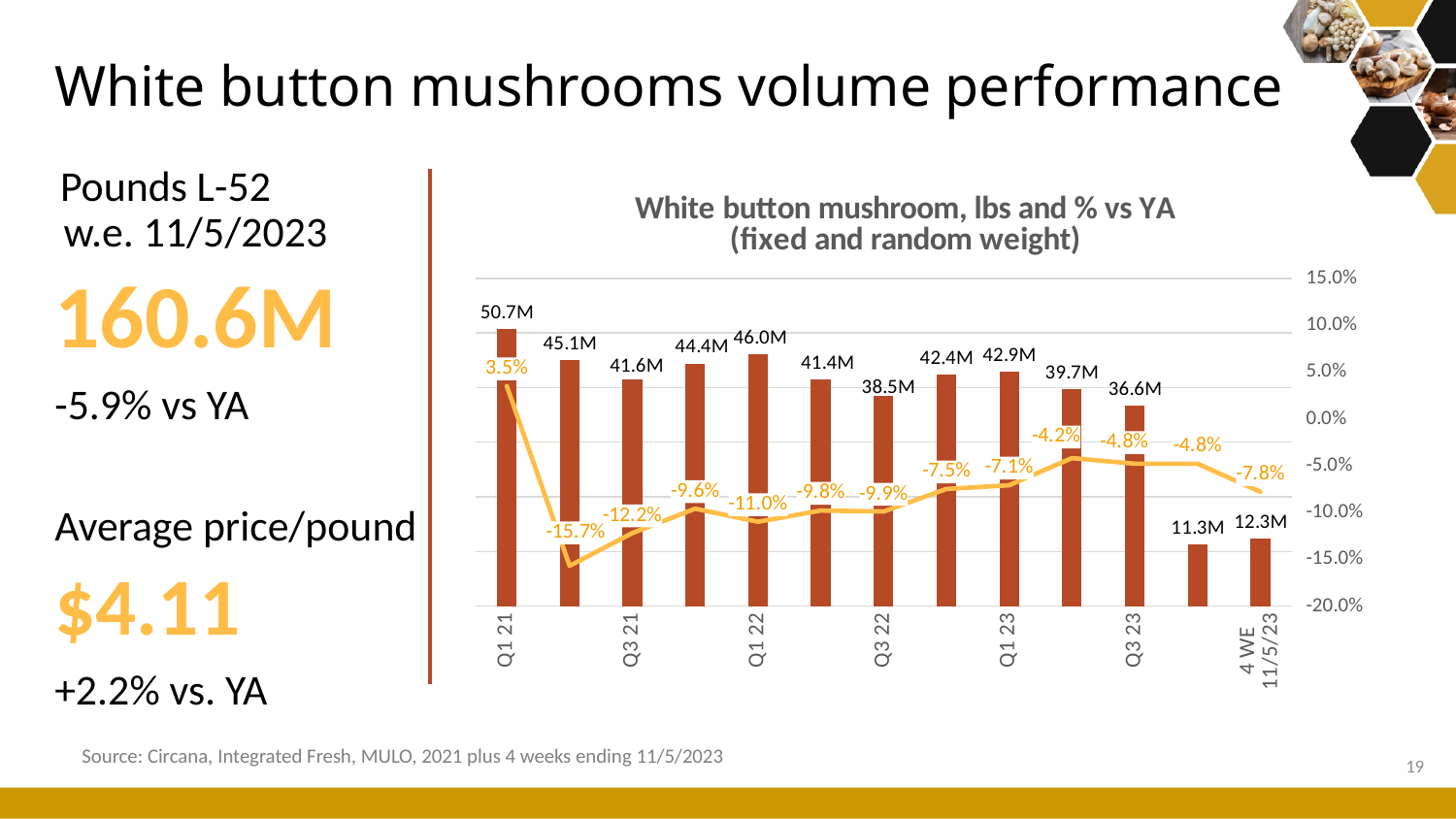
What is the volume in pounds for Q3 23? 36.6M How many bars are plotted in the chart? 13 What kind of chart is shown on the slide? Bar chart with a line What is the volume in pounds for Q1 21? 50.7M What is the difference in volume between Q1 21 and Q3 21? 9.1M What is the lowest % vs YA value shown on the line? -15.7% Which period has the highest volume bar? Q1 21 What is the volume in pounds for 4 WE 11/5/23? 12.3M What is the % vs YA value for Q1 21? 3.5% What is the title of the chart? White button mushroom, lbs and % vs YA (fixed and random weight) What is the % vs YA value for 4 WE 11/5/23? -7.8% Which has the larger volume, Q1 22 or Q1 23? Q1 22